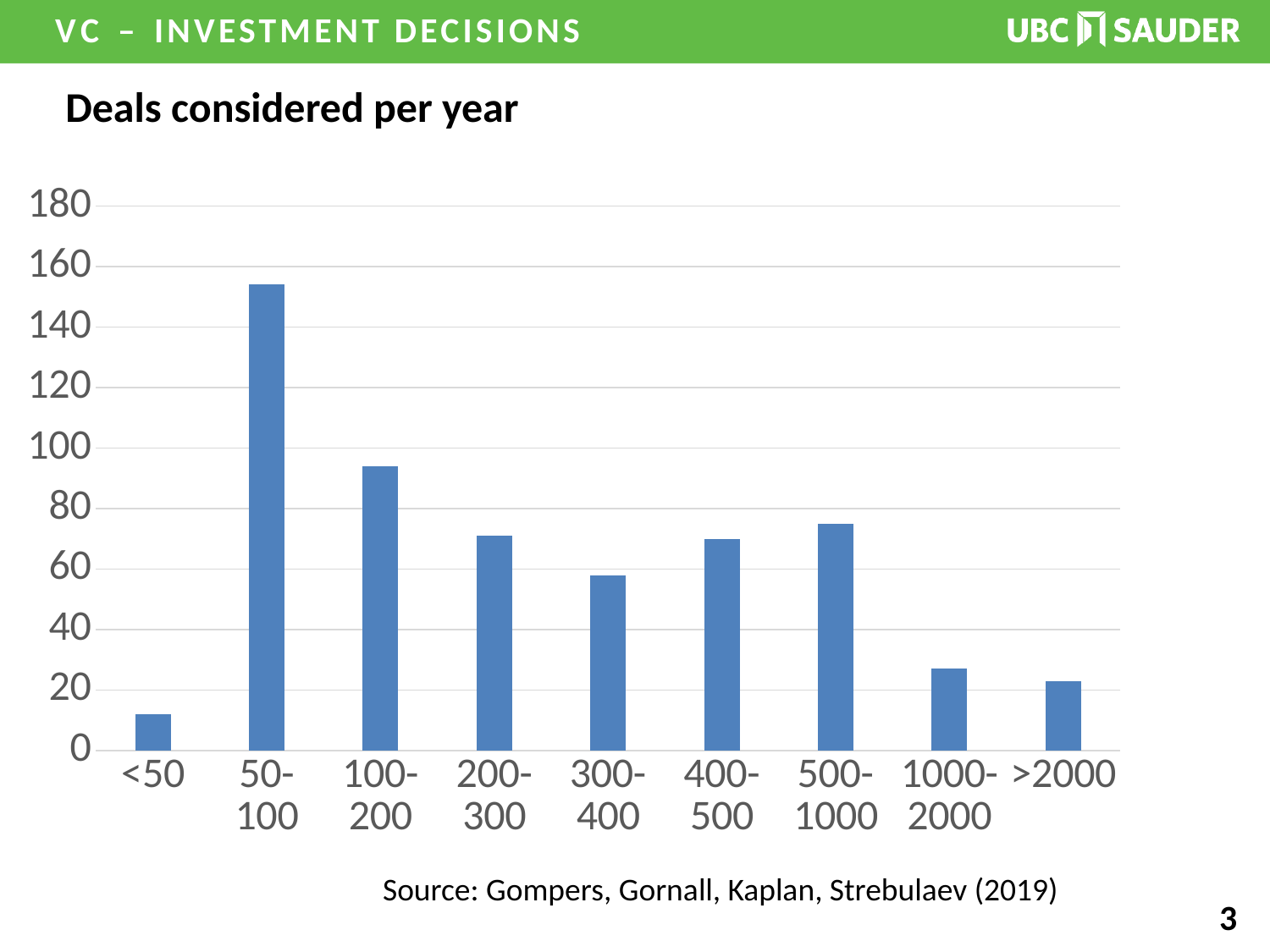
Which is larger, the value for 100-200 or the value for 200-300? 100-200 Which is larger, the value for 300-400 or the value for 500-1000? 500-1000 What source is cited below the chart? Gompers, Gornall, Kaplan, Strebulaev (2019) Is the value for 100-200 greater or less than 100? less Which category has the highest bar? 50-100 Is the value for <50 greater or less than 20? less Is the value for 50-100 greater or less than 140? greater Which category has the lowest bar? <50 How many categories are shown on the x axis of the chart? 9 What is the title of the chart? Deals considered per year What type of chart is shown on the slide? bar chart